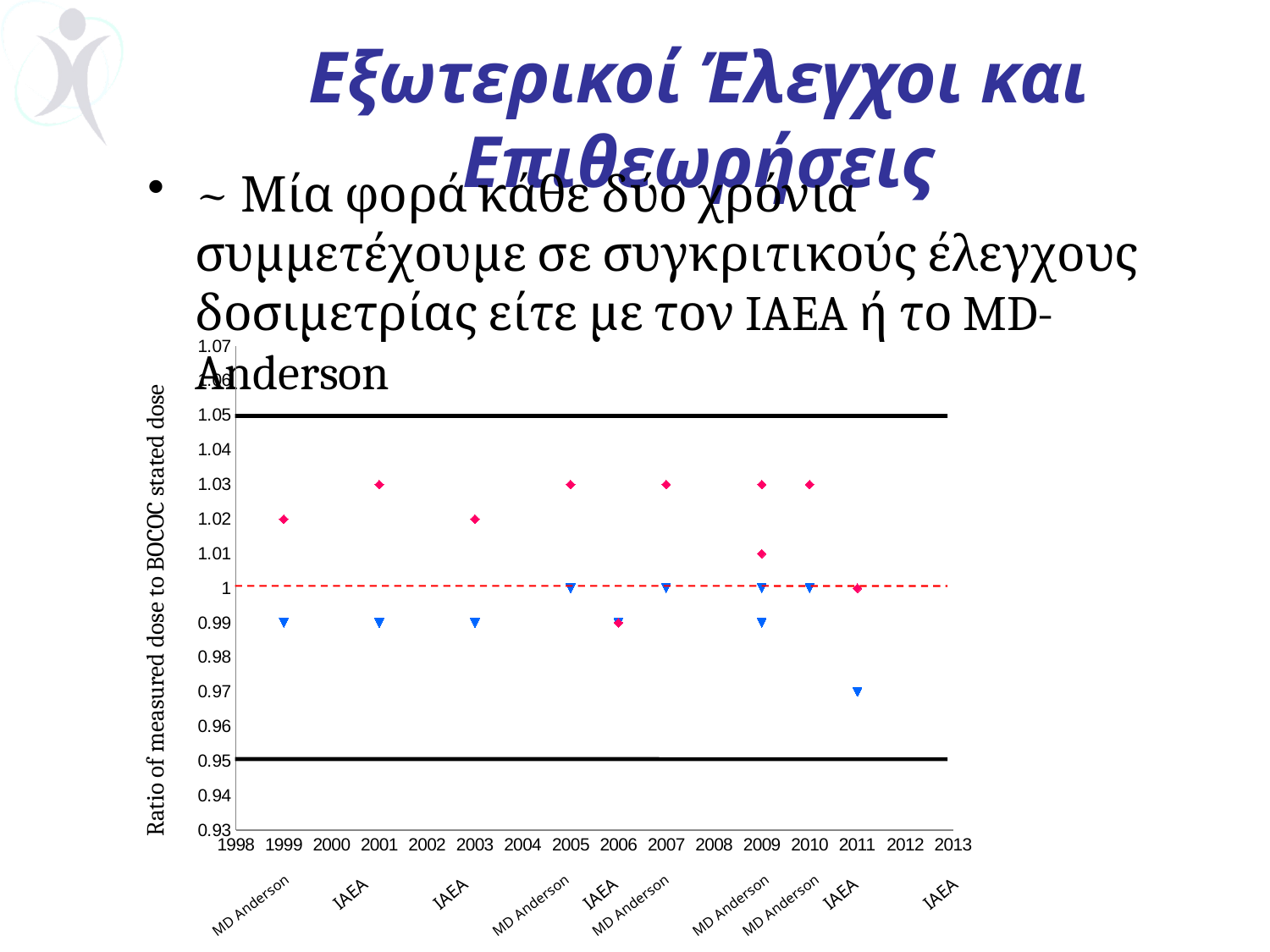
In which year does the blue triangle series reach its lowest value? 2011 At what y-axis values are the two solid black horizontal limit lines drawn? 1.05 and 0.95 Which is larger in 2003, the pink diamond value or the blue triangle value? the pink diamond value What is the value of the pink diamond point in 2001? 1.03 Is the pink diamond value in 2007 greater or less than 1? greater What is the value of the blue triangle point in 2005? 1 What is the difference between the pink diamond value and the blue triangle value in 2001? 0.04 In which year does the pink diamond series have its lowest value? 2006 What kind of chart is shown on the slide? scatter chart What is the value of the blue triangle point in 2011? 0.97 What is the y-axis label of the chart? Ratio of measured dose to BOCOC stated dose What is the value of the pink diamond point in 1999? 1.02